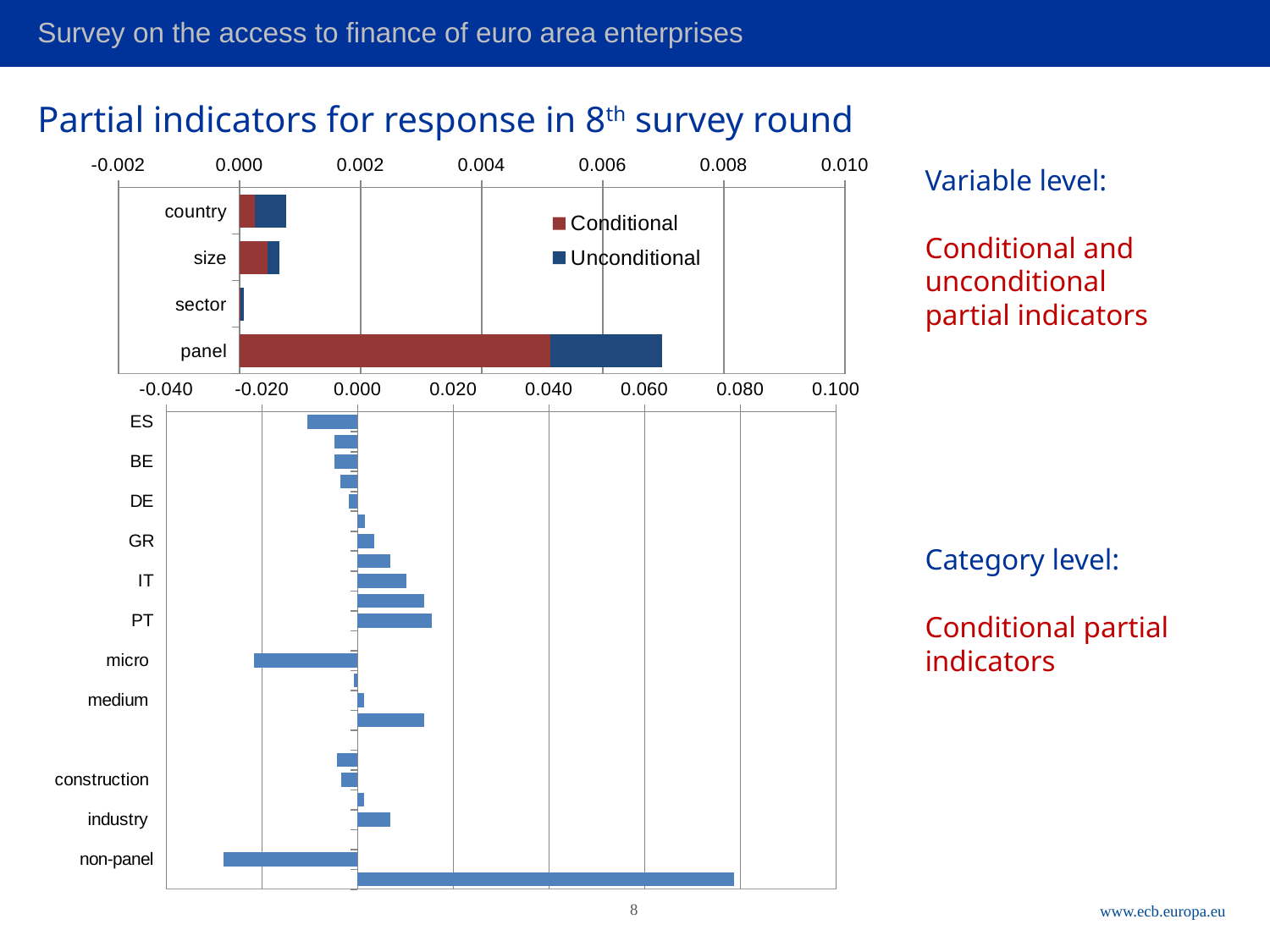
What kind of chart is the top chart on the slide? bar chart In the top chart, which category has the longest total bar? panel How many series does the legend of the top chart list? 2 In the top chart, is the total value for panel greater or less than 0.006? greater In the bottom chart, which labelled category has the most negative value? non-panel In the bottom chart, is the value for non-panel greater or less than -0.020? less What kind of chart is the bottom chart on the slide? bar chart How many categories are shown on the vertical axis of the top chart? 4 In the top chart, which colour represents the Conditional series? red In the bottom chart, which is larger, the value for ES or the value for PT? PT In the top chart, is the total value for country greater or less than 0.002? less In the top chart, which category has the shortest total bar? sector